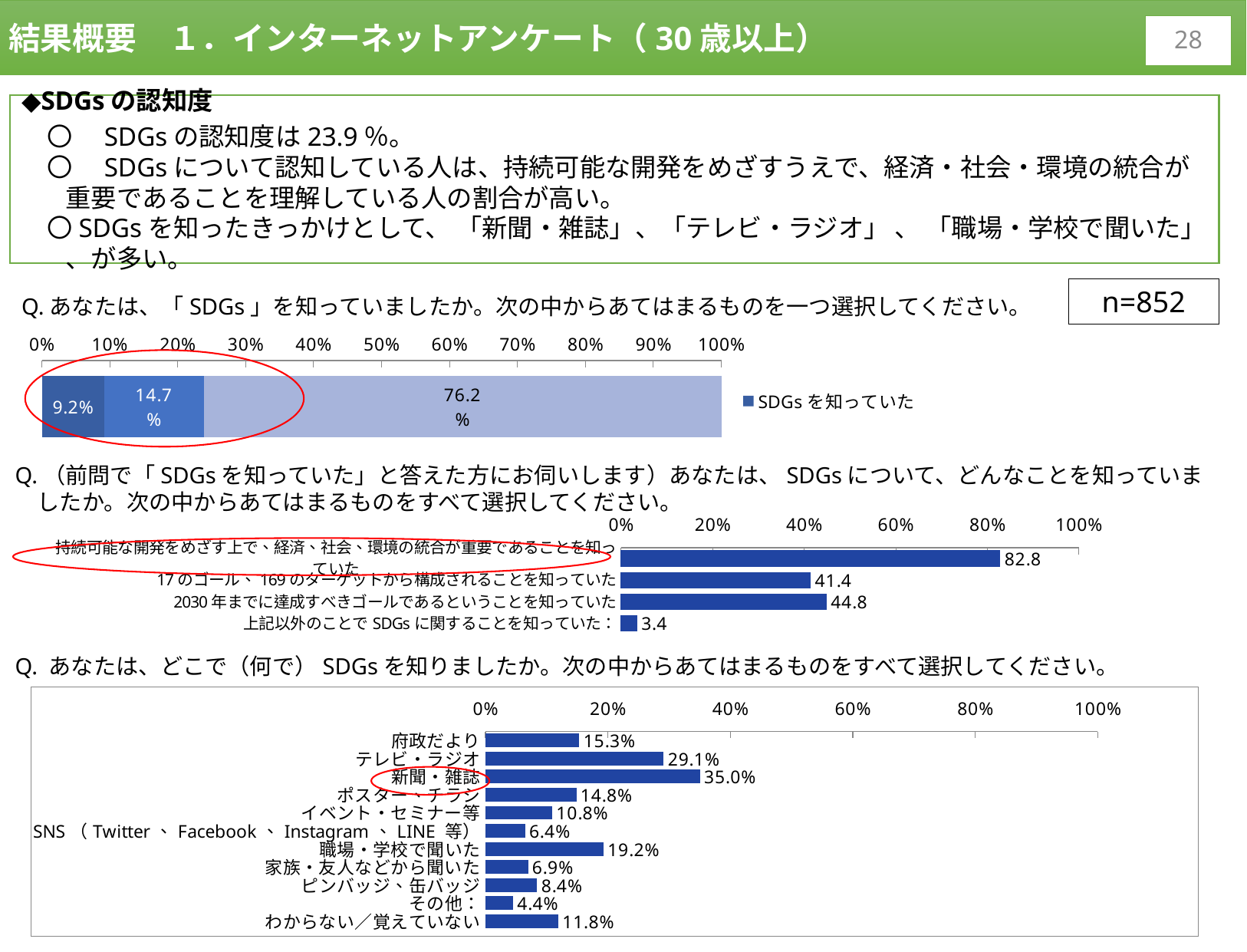
In the middle chart (what people knew about SDGs), what is the value for 2030年までに達成すべきゴールであるということを知っていた? 44.8 In the top stacked bar chart (awareness of SDGs), what is the value of the largest segment? 76.2% In the bottom chart (where people learned about SDGs), which is larger: 家族・友人などから聞いた or ピンバッジ、缶バッジ? ピンバッジ、缶バッジ What kind of chart is the bottom chart (where people learned about SDGs)? bar chart In the bottom chart (where people learned about SDGs), which category has the lowest value? その他 In the bottom chart (where people learned about SDGs), what is the difference between テレビ・ラジオ and 府政だより? 13.8% How many categories are shown in the bottom chart (where people learned about SDGs)? 11 In the bottom chart (where people learned about SDGs), what is the value for 新聞・雑誌? 35.0% In the bottom chart (where people learned about SDGs), what is the value for 職場・学校で聞いた? 19.2% In the bottom chart (where people learned about SDGs), which category has the highest value? 新聞・雑誌 How many categories are shown in the middle chart (what people knew about SDGs)? 4 In the middle chart (what people knew about SDGs), which category has the highest value? 持続可能な開発をめざす上で、経済、社会、環境の統合が重要であることを知っていた